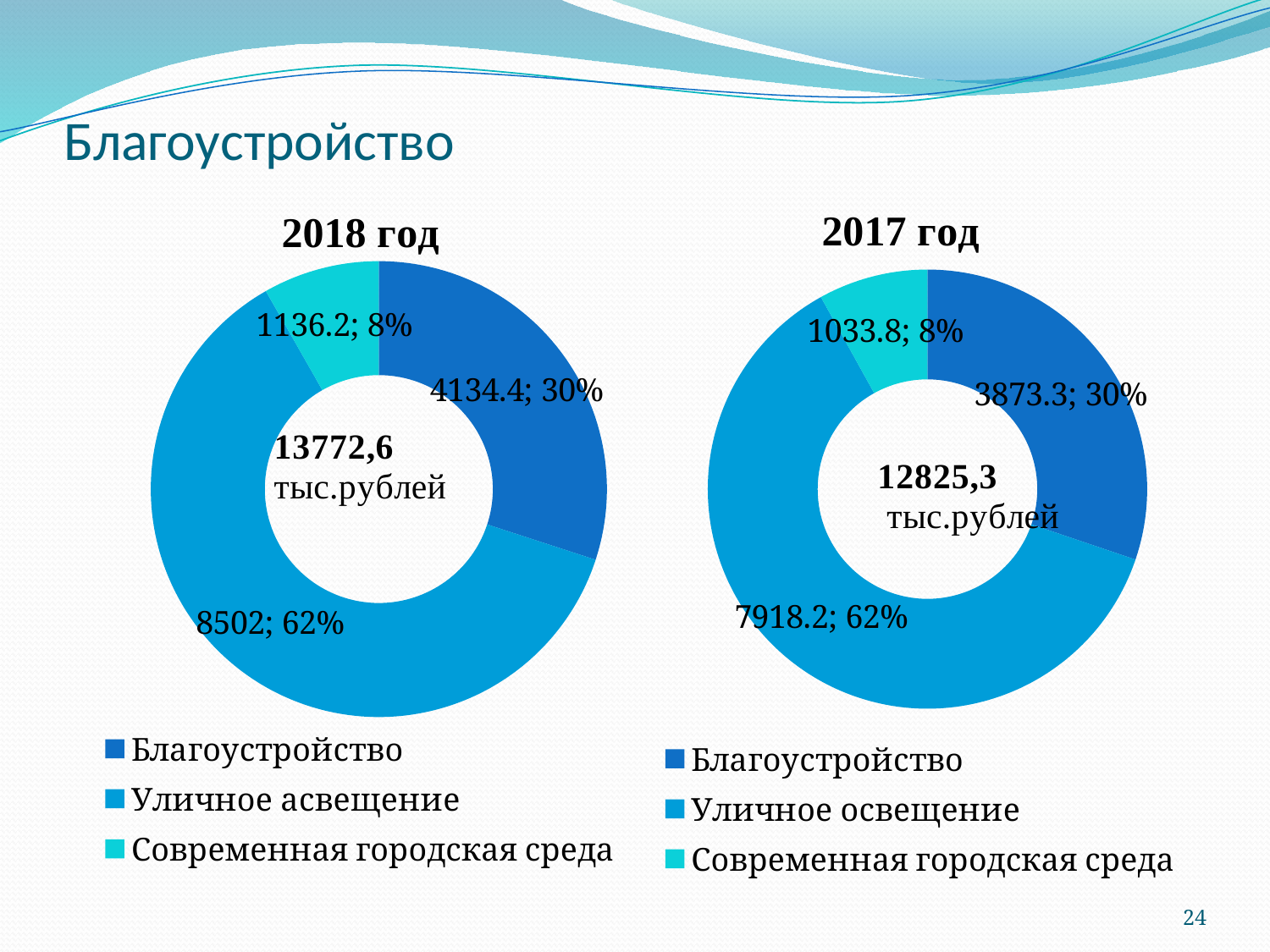
In the "2018 год" chart, which category has the largest value? Уличное асвещение In the "2018 год" chart, what is the value for Уличное асвещение? 8502 How many categories does the "2017 год" chart show? 3 Which is larger: the value for Современная городская среда in the "2018 год" chart or in the "2017 год" chart? 2018 год In the "2017 год" chart, which category has the smallest value? Современная городская среда What type of chart is the "2018 год" chart? Doughnut (pie) chart What total is printed in the centre of the "2017 год" chart? 12825,3 тыс.рублей In the "2017 год" chart, what is the difference between the values for Уличное освещение and Благоустройство? 4044.9 In the "2017 год" chart, what is the value for Благоустройство? 3873.3 In the "2017 год" chart, what share of the total does Современная городская среда represent? 8% In the "2018 год" chart, what is the difference between the values for Уличное асвещение and Благоустройство? 4367.6 In the "2018 год" chart, what share of the total does Благоустройство represent? 30%